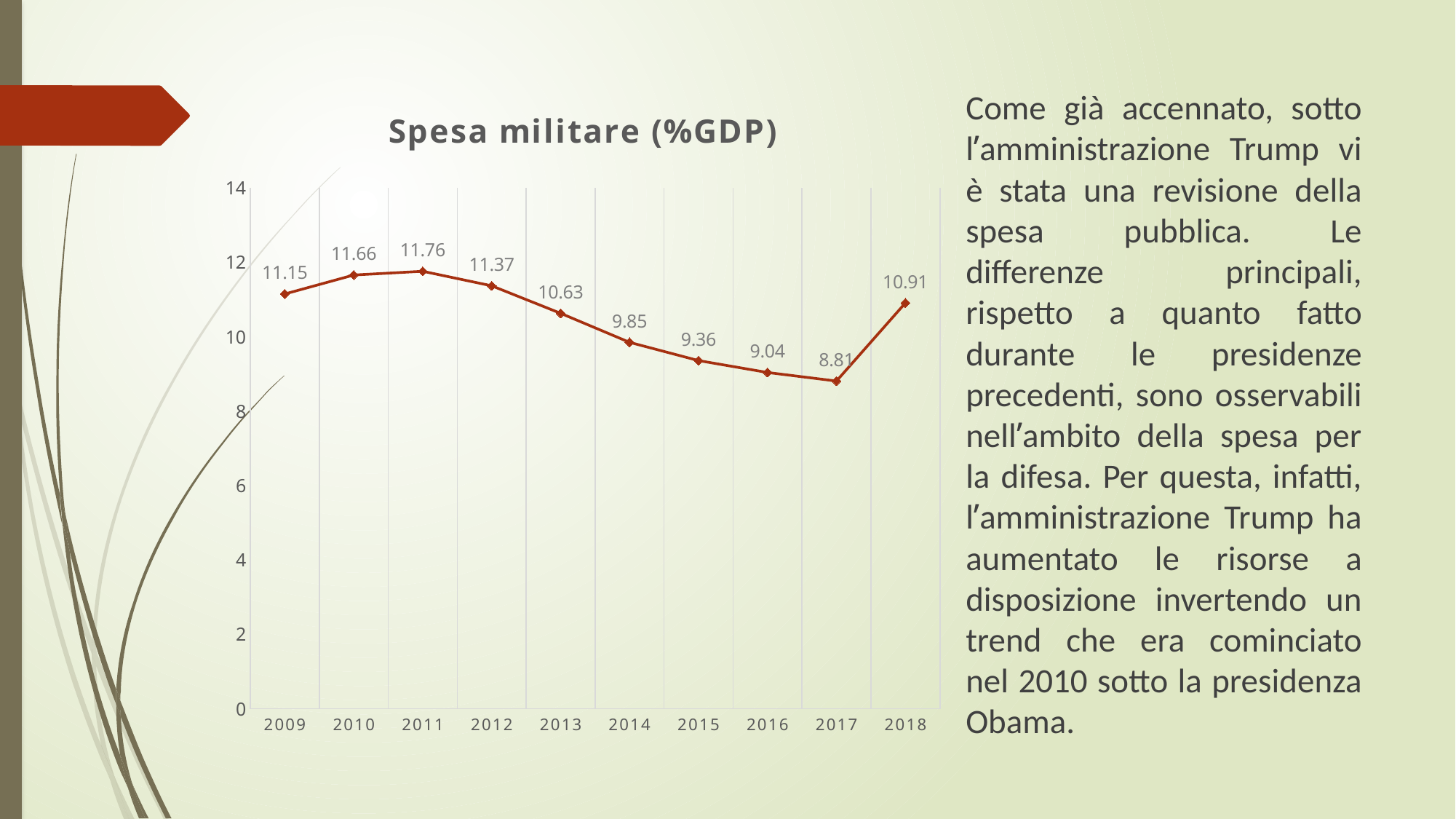
Which year has the highest value? 2011 Do the values rise or fall from 2011 to 2017? fall What is the difference between the values for 2011 and 2017? 2.95 How many years are plotted on the chart? 10 Which is larger, the value for 2009 or the value for 2018? 2009 Is the value for 2015 greater or less than 10? less What is the value for 2018? 10.91 Which year has the lowest value? 2017 What is the title of the chart? Spesa militare (%GDP) What kind of chart is shown? line chart What is the value for 2017? 8.81 What is the value for 2011? 11.76